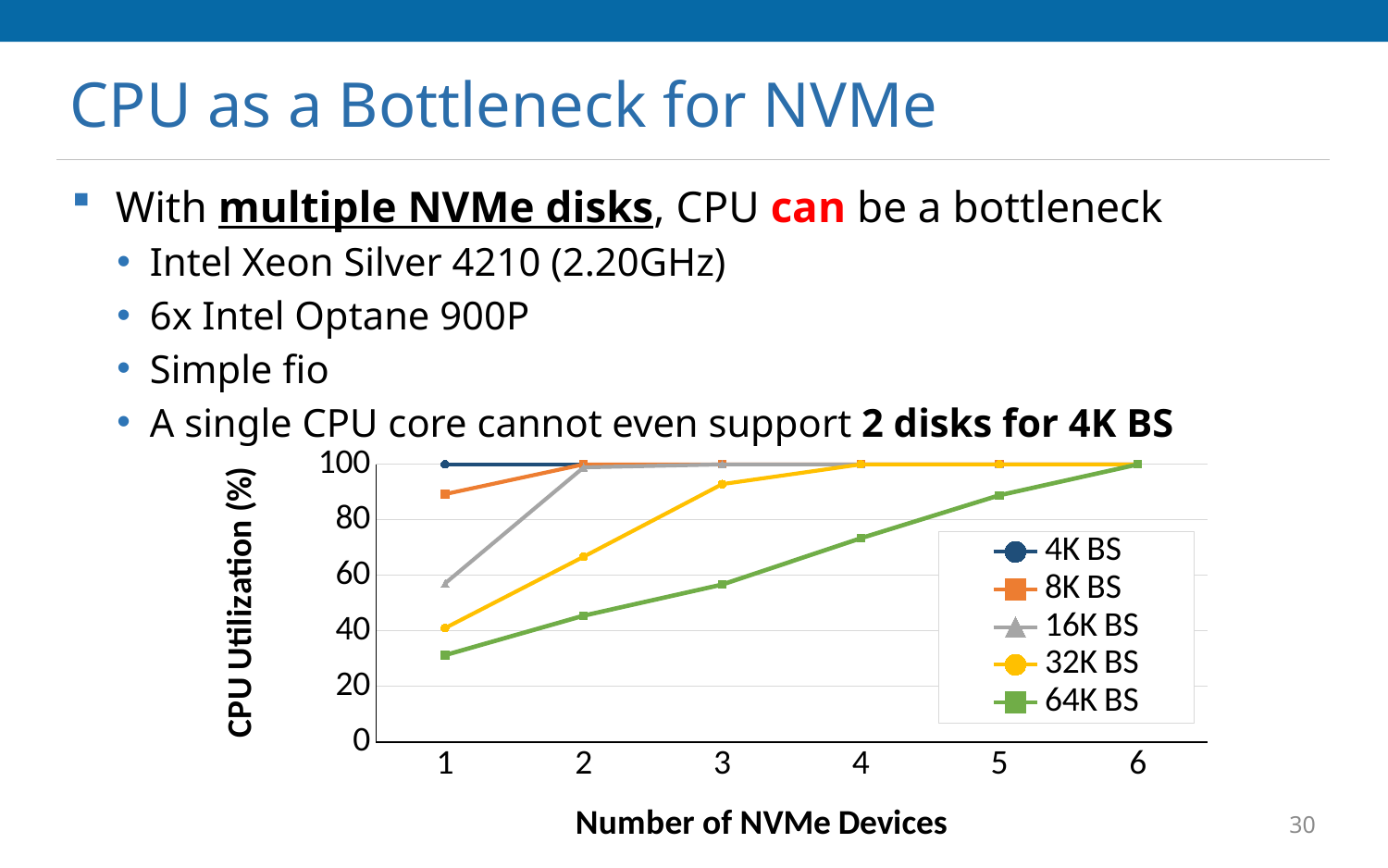
Is the CPU Utilization (%) for 8K BS at 1 NVMe device greater or less than 80? greater What kind of chart is shown on the slide? line chart Is the CPU Utilization (%) for 64K BS at 1 NVMe device greater or less than 40? less What is the CPU Utilization (%) for 64K BS with 6 NVMe devices? 100 What is the label of the y axis? CPU Utilization (%) How many values of Number of NVMe Devices are plotted along the x axis? 6 What is the CPU Utilization (%) for 4K BS with 1 NVMe device? 100 How many series does the legend list? 5 At 2 NVMe devices, which has higher CPU Utilization (%): 32K BS or 64K BS? 32K BS Which series has the highest CPU Utilization (%) at 1 NVMe device? 4K BS Does the CPU Utilization (%) for 64K BS rise or fall as the Number of NVMe Devices increases? rise Which series has the lowest CPU Utilization (%) at 1 NVMe device? 64K BS